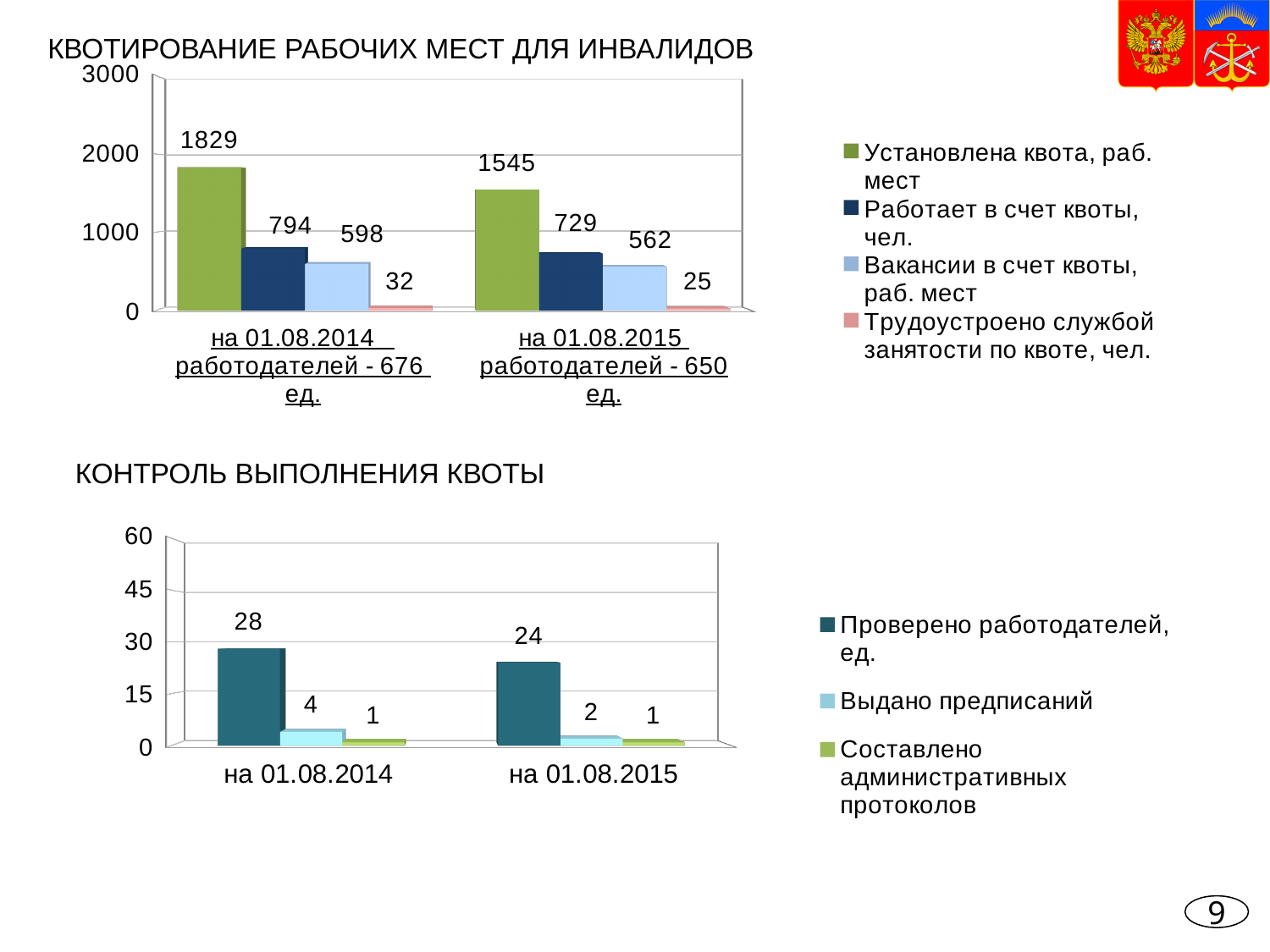
In the bottom chart (КОНТРОЛЬ ВЫПОЛНЕНИЯ КВОТЫ), what is the difference between 'Проверено работодателей, ед.' for на 01.08.2014 and на 01.08.2015? 4 In the top chart (КВОТИРОВАНИЕ РАБОЧИХ МЕСТ ДЛЯ ИНВАЛИДОВ), what is the value of 'Трудоустроено службой занятости по квоте, чел.' for на 01.08.2014? 32 In the top chart (КВОТИРОВАНИЕ РАБОЧИХ МЕСТ ДЛЯ ИНВАЛИДОВ), how many series does the legend list? 4 What type of chart is the bottom chart (КОНТРОЛЬ ВЫПОЛНЕНИЯ КВОТЫ)? bar chart In the top chart (КВОТИРОВАНИЕ РАБОЧИХ МЕСТ ДЛЯ ИНВАЛИДОВ), what is the value of 'Установлена квота, раб. мест' for на 01.08.2014? 1829 In the bottom chart (КОНТРОЛЬ ВЫПОЛНЕНИЯ КВОТЫ), what is the value of 'Проверено работодателей, ед.' for на 01.08.2015? 24 In the top chart (КВОТИРОВАНИЕ РАБОЧИХ МЕСТ ДЛЯ ИНВАЛИДОВ), what is the value of 'Вакансии в счет квоты, раб. мест' for на 01.08.2015? 562 In the top chart (КВОТИРОВАНИЕ РАБОЧИХ МЕСТ ДЛЯ ИНВАЛИДОВ), what is the difference between 'Установлена квота, раб. мест' for на 01.08.2014 and на 01.08.2015? 284 In the top chart (КВОТИРОВАНИЕ РАБОЧИХ МЕСТ ДЛЯ ИНВАЛИДОВ), which is larger: 'Работает в счет квоты, чел.' for на 01.08.2014 or for на 01.08.2015? на 01.08.2014 In the top chart (КВОТИРОВАНИЕ РАБОЧИХ МЕСТ ДЛЯ ИНВАЛИДОВ), does the value of 'Установлена квота, раб. мест' rise or fall from на 01.08.2014 to на 01.08.2015? fall In the bottom chart (КОНТРОЛЬ ВЫПОЛНЕНИЯ КВОТЫ), which series has the highest value for на 01.08.2014? Проверено работодателей, ед. In the bottom chart (КОНТРОЛЬ ВЫПОЛНЕНИЯ КВОТЫ), what is the value of 'Выдано предписаний' for на 01.08.2014? 4